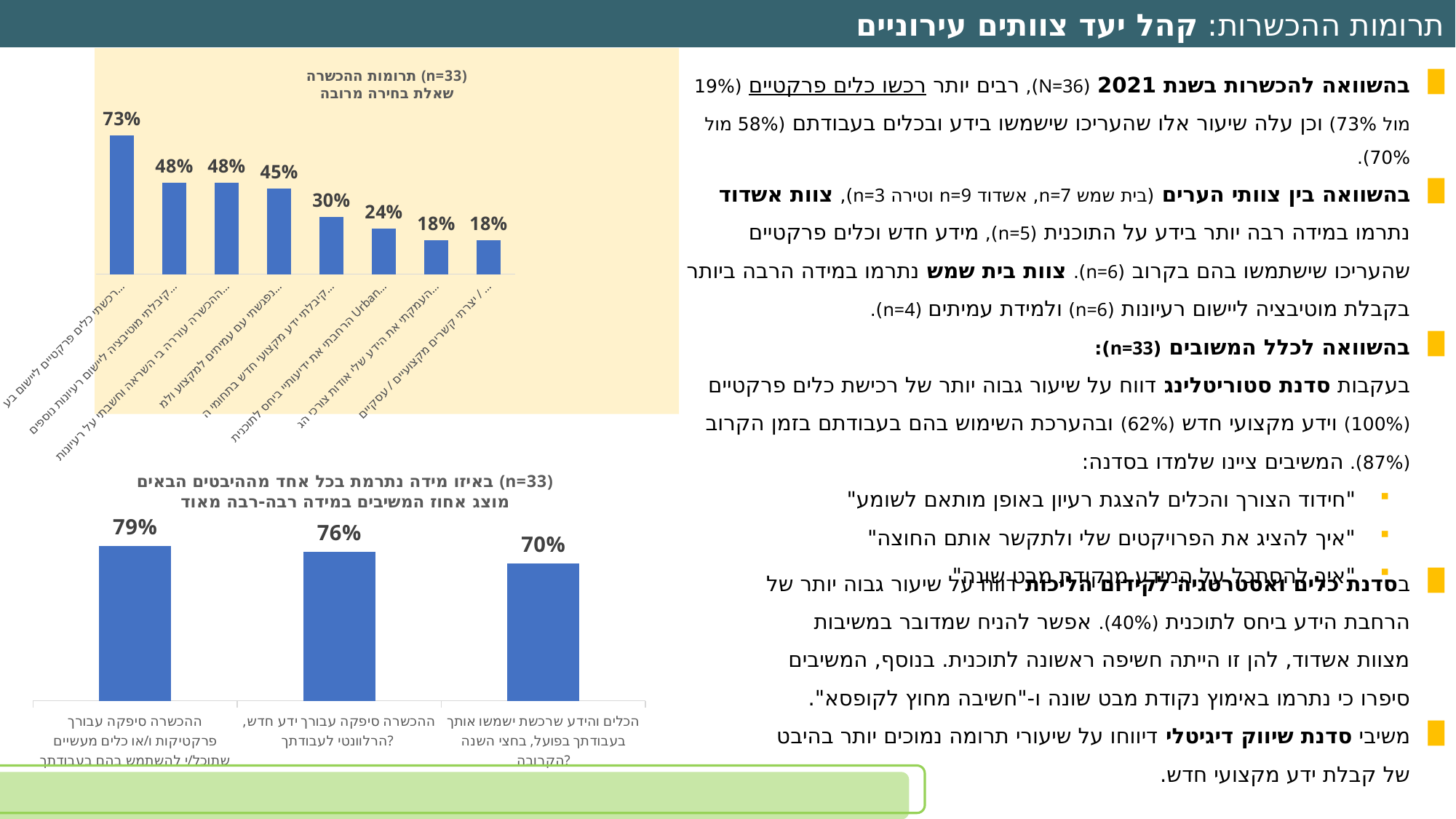
In the top chart, what is the value of the lowest bars? 18% In the top chart, do the values rise or fall from left to right? fall In the top chart ("תרומות ההכשרה (n=33)"), what is the value of the tallest bar? 73% What is the sample size (n) stated in the title of the top chart? n=33 In the bottom chart, what is the difference between the highest value (79%) and the lowest value (70%)? 9% In the bottom chart, which category has the highest value? ההכשרה סיפקה עבורך פרקטיקות ו/או כלים מעשיים שתוכל/י להשתמש בהם בעבודתך In the top chart, what is the difference between the first bar (73%) and the second bar (48%)? 25% How many bars are in the bottom chart? 3 What type of chart is the bottom chart on the slide? bar chart How many bars are in the top chart ("תרומות ההכשרה")? 8 In the bottom chart ("באיזו מידה נתרמת בכל אחד מההיבטים הבאים"), what percentage is shown for "ההכשרה סיפקה עבורך ידע חדש, הרלוונטי לעבודתך"? 76% In the bottom chart, what percentage is shown for "הכלים והידע שרכשת ישמשו אותך בעבודתך בפועל, בחצי השנה הקרובה"? 70%